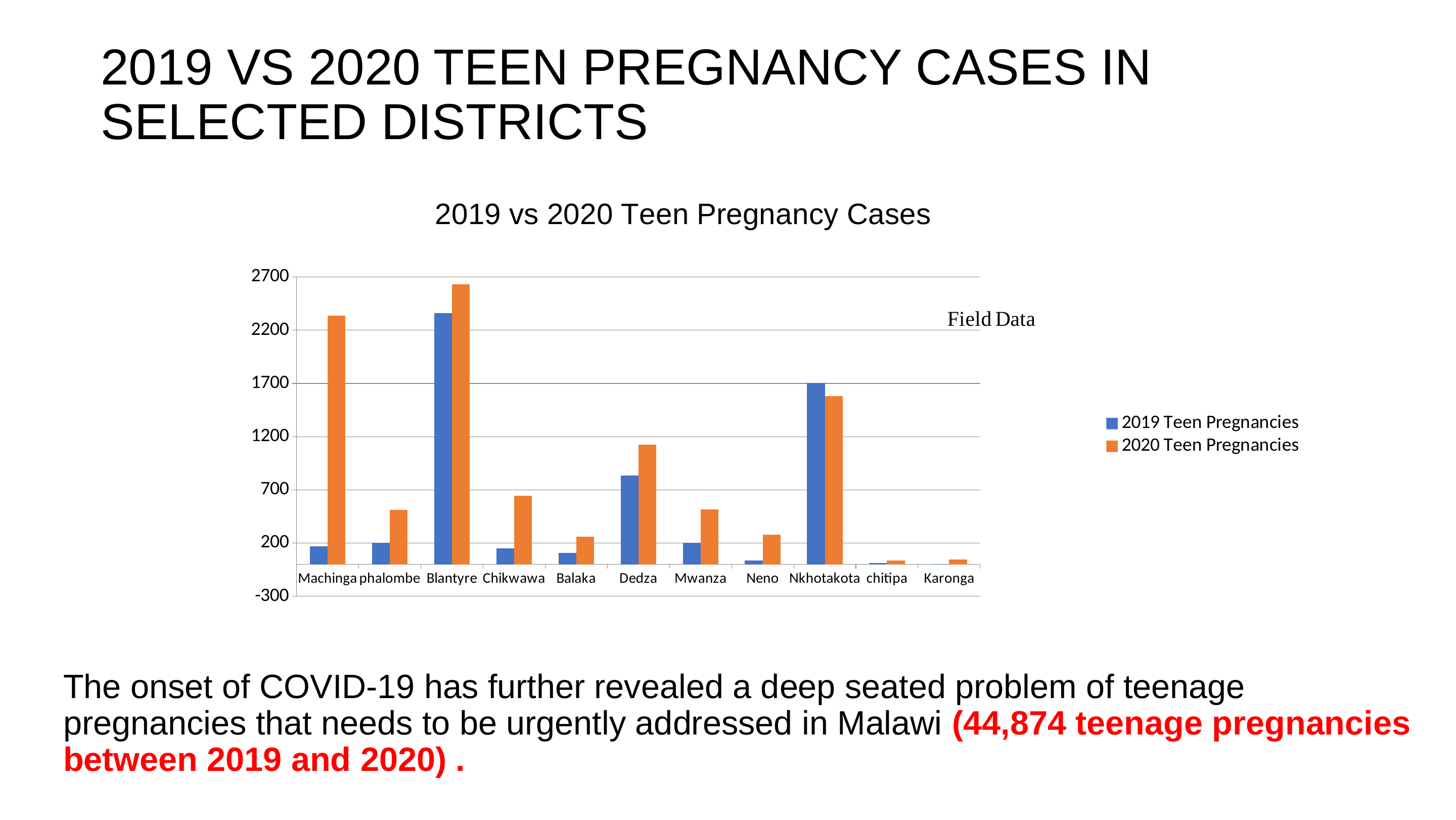
Is the value for 2020 Teen Pregnancies in Nkhotakota greater or less than 1700? less What kind of chart is shown on the slide? bar chart Is the value for 2019 Teen Pregnancies in Dedza greater or less than 700? greater In Machinga, which series has the larger value, 2019 Teen Pregnancies or 2020 Teen Pregnancies? 2020 Teen Pregnancies Which district has the highest value for 2020 Teen Pregnancies? Blantyre How many series does the legend list? 2 What colour represents 2020 Teen Pregnancies in the chart? orange Is the value for 2019 Teen Pregnancies in Balaka greater or less than 200? less In Nkhotakota, which series has the larger value, 2019 Teen Pregnancies or 2020 Teen Pregnancies? 2019 Teen Pregnancies Which district has the highest value for 2019 Teen Pregnancies? Blantyre How many districts are shown on the x axis of the chart? 11